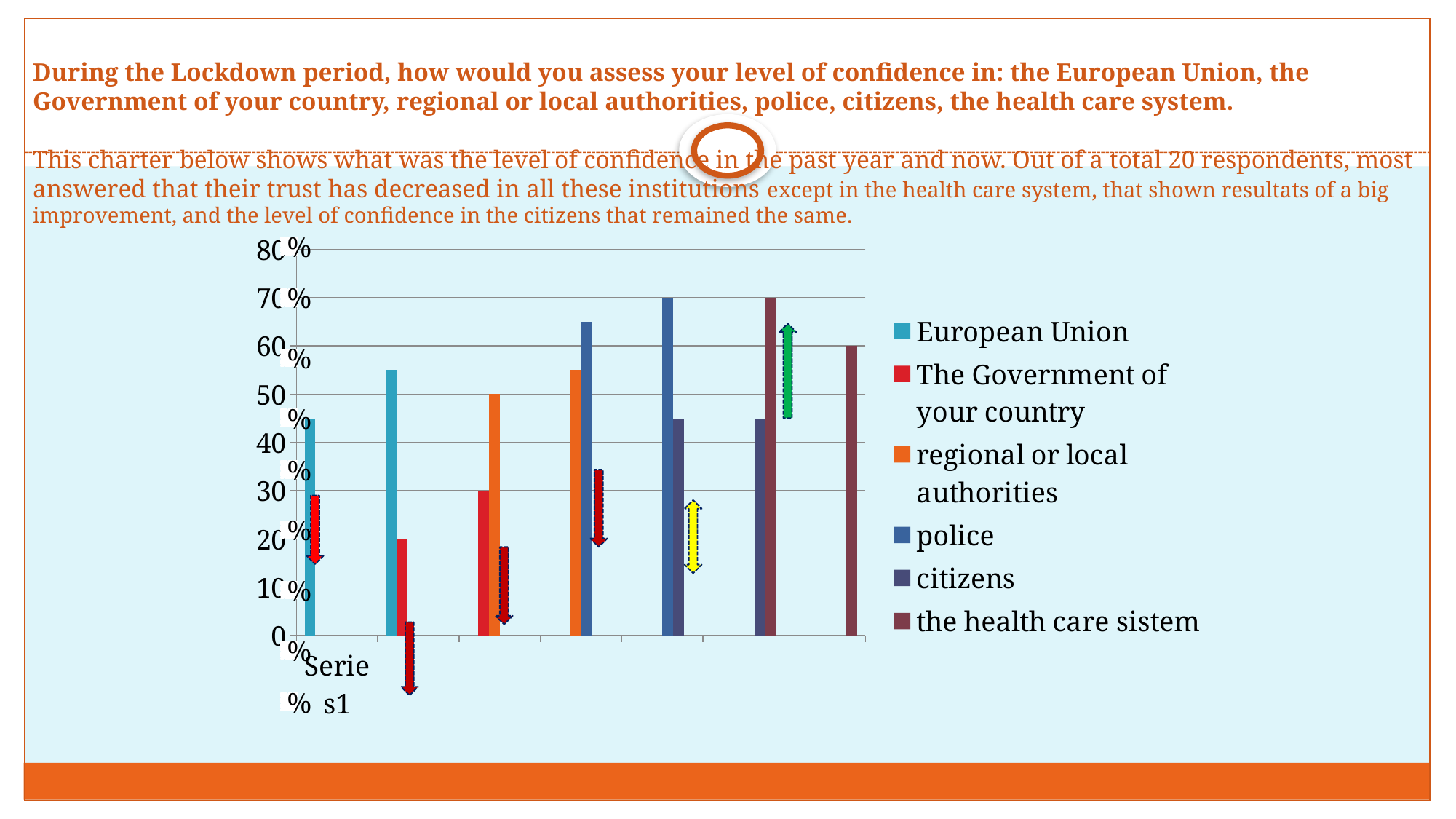
Which series is listed last in the chart legend? the health care sistem Are the bars for citizens greater or less than 50%? less Is the tallest bar for regional or local authorities greater or less than 40%? greater Which series has the lowest bar on the chart? The Government of your country What kind of chart is shown on the slide? bar chart Is the tallest bar for police greater or less than 60%? greater Is the tallest bar for police larger or smaller than the tallest bar for citizens? larger How many series does the chart legend list? 6 What is the highest value shown on the chart's vertical axis? 80%